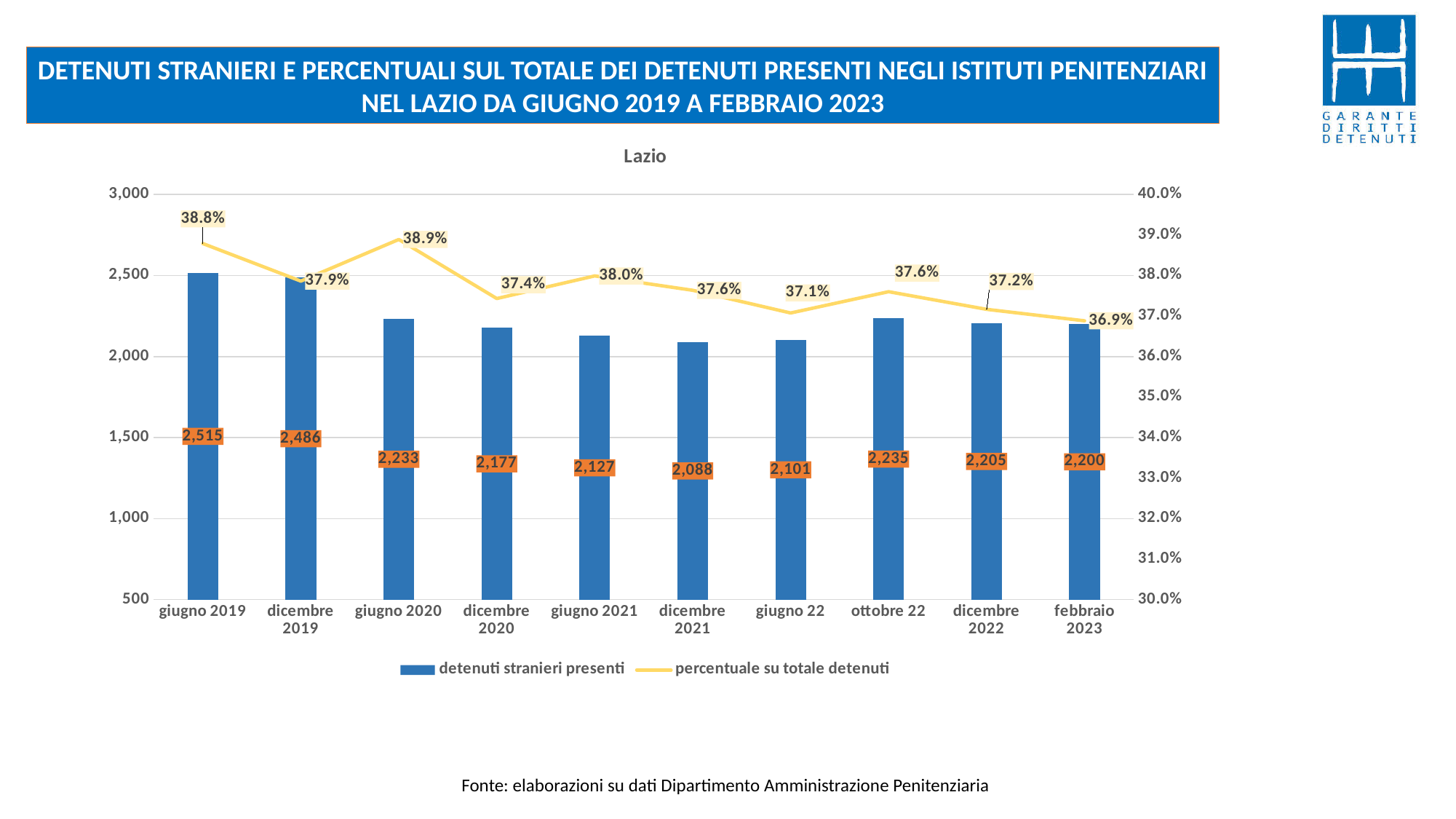
Which is larger, the number of detenuti stranieri presenti in ottobre 22 or in giugno 2020? ottobre 22 Which period has the highest number of detenuti stranieri presenti? giugno 2019 How many time periods are shown on the x axis? 10 How many foreign detainees (detenuti stranieri presenti) were there in giugno 2019? 2,515 Which period has the lowest number of detenuti stranieri presenti? dicembre 2021 What is the percentage on total detainees (percentuale su totale detenuti) for giugno 2020? 38.9% What is the value of detenuti stranieri presenti for febbraio 2023? 2,200 Which period has the lowest percentuale su totale detenuti? febbraio 2023 What kind of chart is used for the detenuti stranieri presenti series? bar chart How many series does the legend list? 2 What is the title shown above the plot area? Lazio What is the difference in detenuti stranieri presenti between giugno 2019 and febbraio 2023? 315